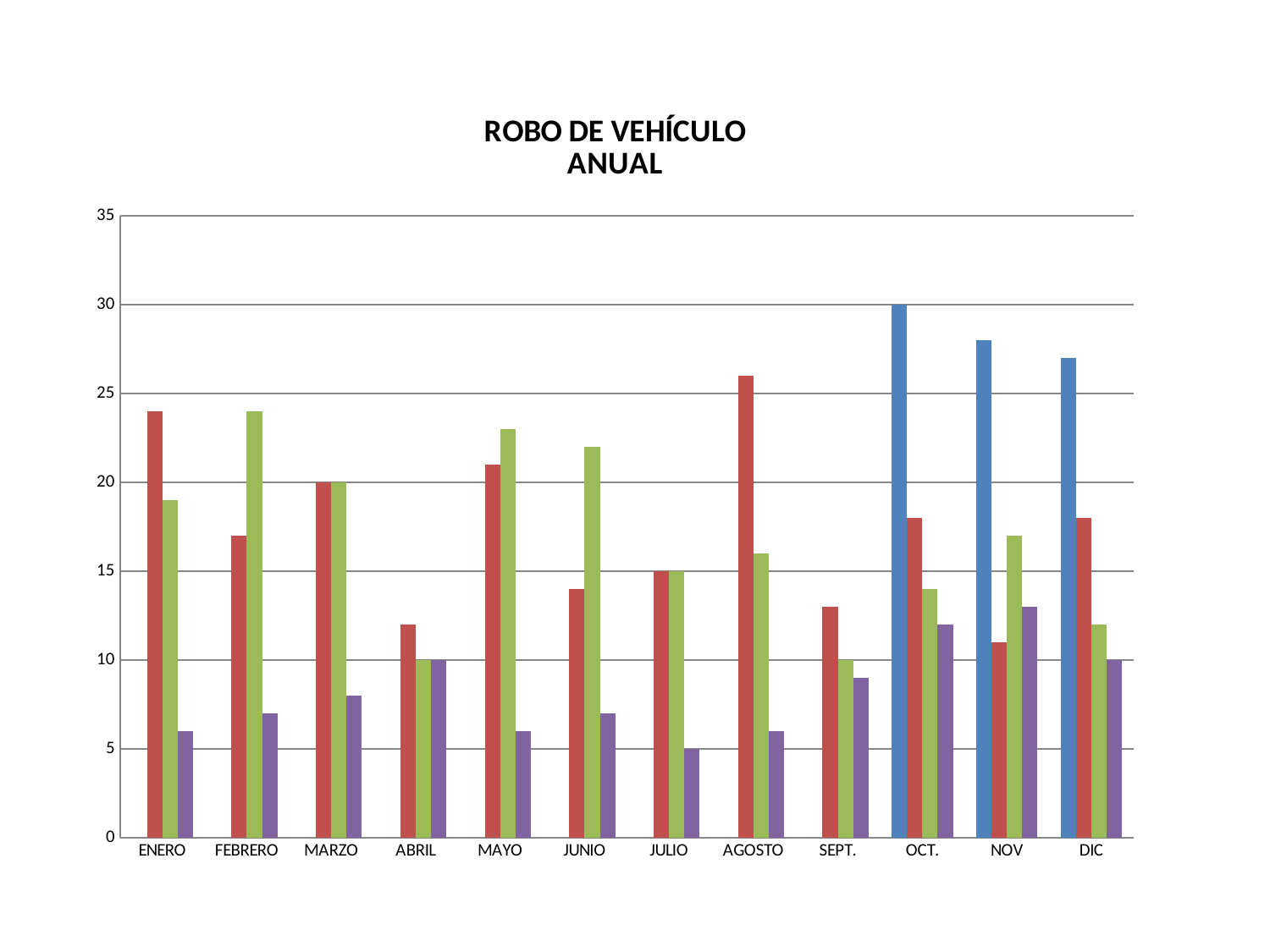
How many months (categories) are shown on the x axis? 12 Is the value of the purple bar for FEBRERO greater or less than 10? less What is the value of the red bar for MARZO? 20 What kind of chart is shown on the slide? bar chart What is the value of the purple bar for JULIO? 5 What is the value of the green bar for ABRIL? 10 What is the value of the blue bar for OCT.? 30 What is the difference between the red bar and the purple bar for JULIO? 10 For ENERO, which is larger: the red bar or the green bar? the red bar Which month has the tallest bar in the chart? OCT. Is the value of the red bar for AGOSTO greater or less than 25? greater What is the title of the chart? ROBO DE VEHÍCULO ANUAL